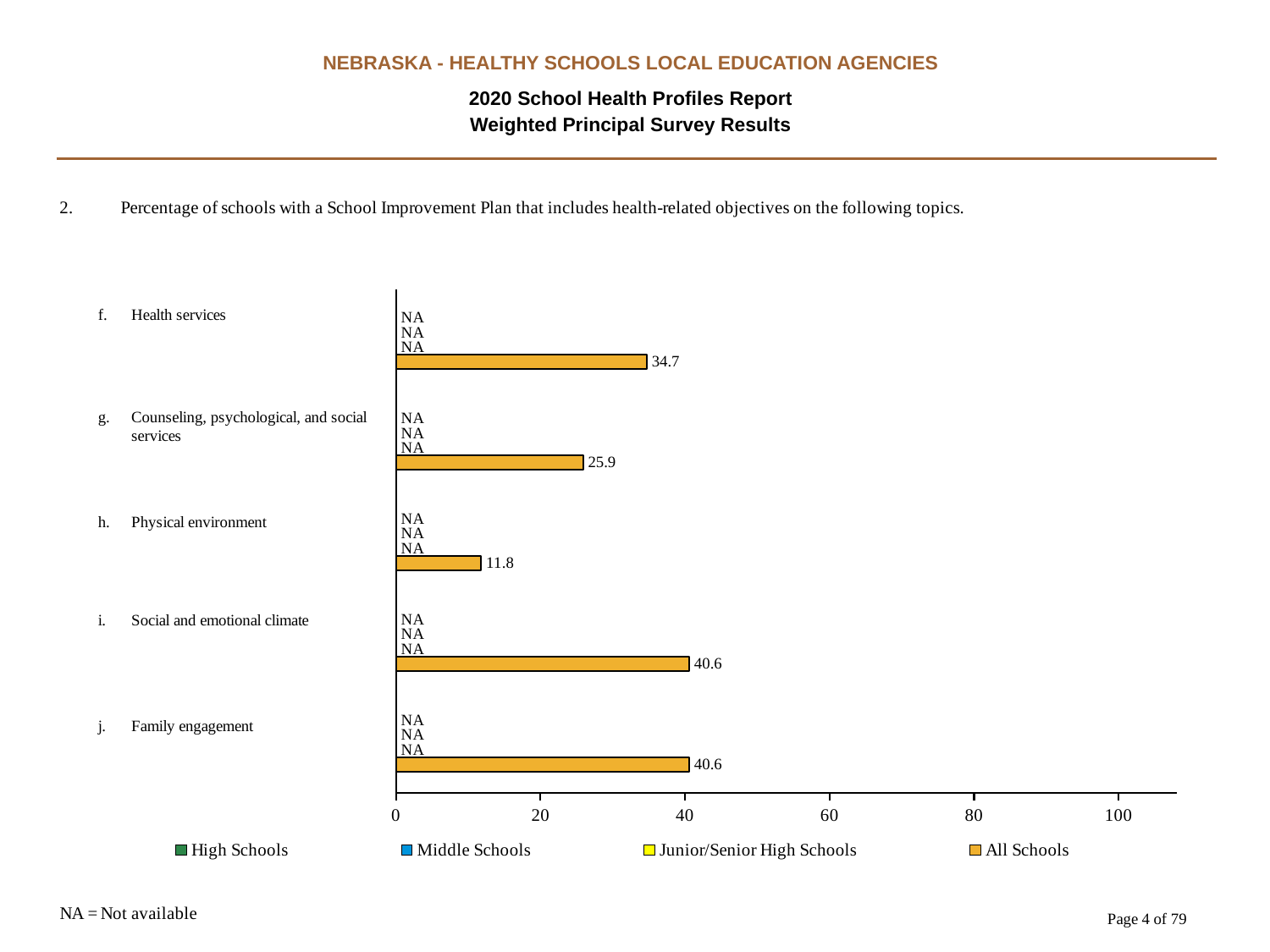
Is the All Schools value for Social and emotional climate greater or less than 40? greater What value is shown for High Schools for Health services? NA What is the All Schools value for Health services? 34.7 What kind of chart is shown? bar chart What is the All Schools value for Family engagement? 40.6 Which is larger for All Schools: Health services or Counseling, psychological, and social services? Health services How many series does the legend list? 4 Which topic has the lowest All Schools value? Physical environment What is the All Schools value for Counseling, psychological, and social services? 25.9 How many topics are listed on the chart? 5 What is the difference between the All Schools values for Health services and Physical environment? 22.9 What is the All Schools value for Physical environment? 11.8